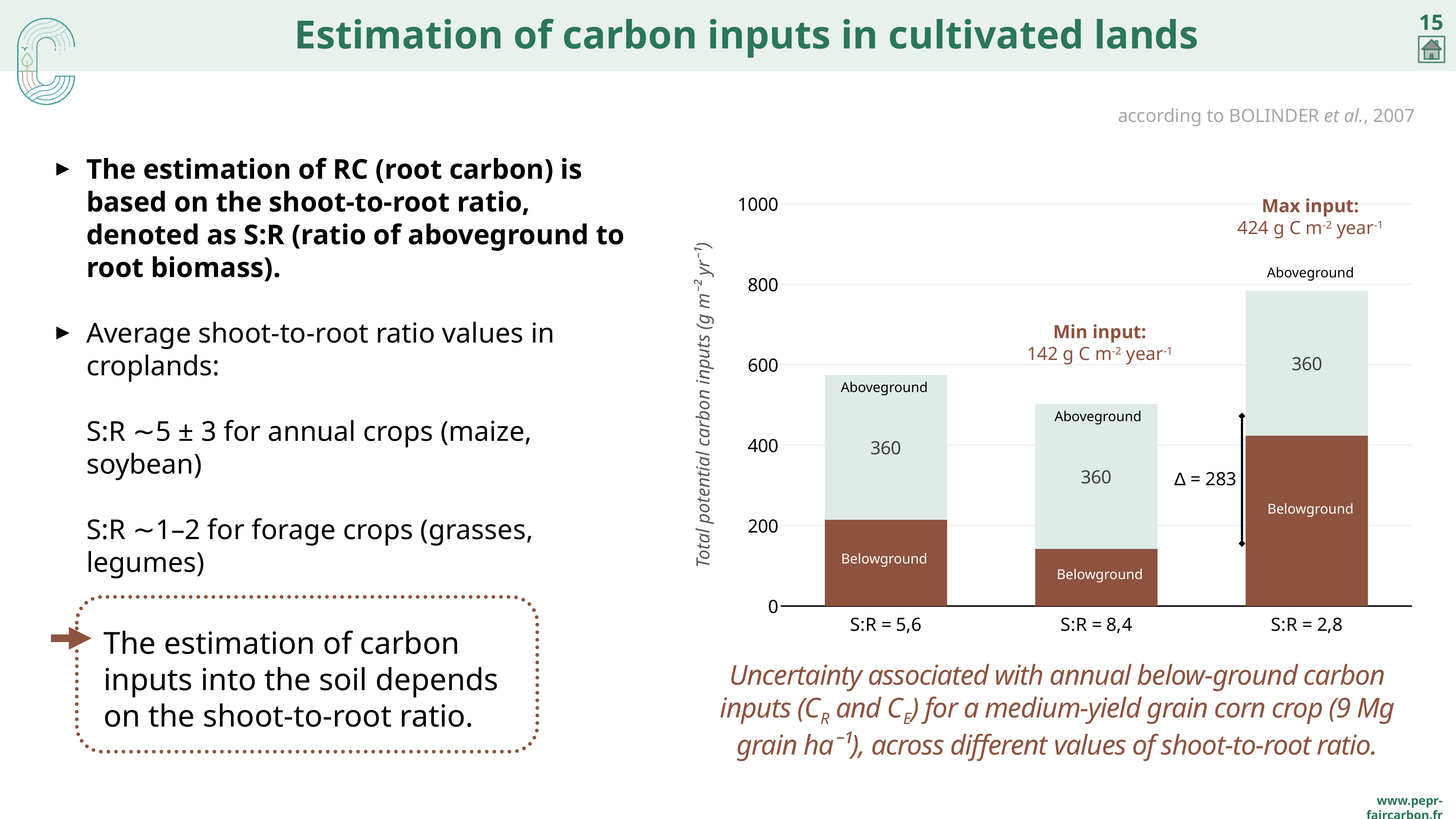
What kind of chart is shown on the slide? bar chart How many shoot-to-root ratio categories are shown on the x axis? 3 What is the Δ value annotated between the minimum and maximum belowground inputs? 283 What is the Max input value annotated on the chart? 424 g C m-2 year-1 How many series are stacked in each bar? 2 Which shoot-to-root ratio category has the shortest total bar? S:R = 8,4 What is the total of the stacked bar for S:R = 2,8 (Aboveground 360 plus Max input 424)? 784 What is the Aboveground value for S:R = 5,6? 360 What is the label of the y axis? Total potential carbon inputs (g m−2 yr−1) Which shoot-to-root ratio category has the tallest total bar? S:R = 2,8 What is the Min input value annotated on the chart? 142 g C m-2 year-1